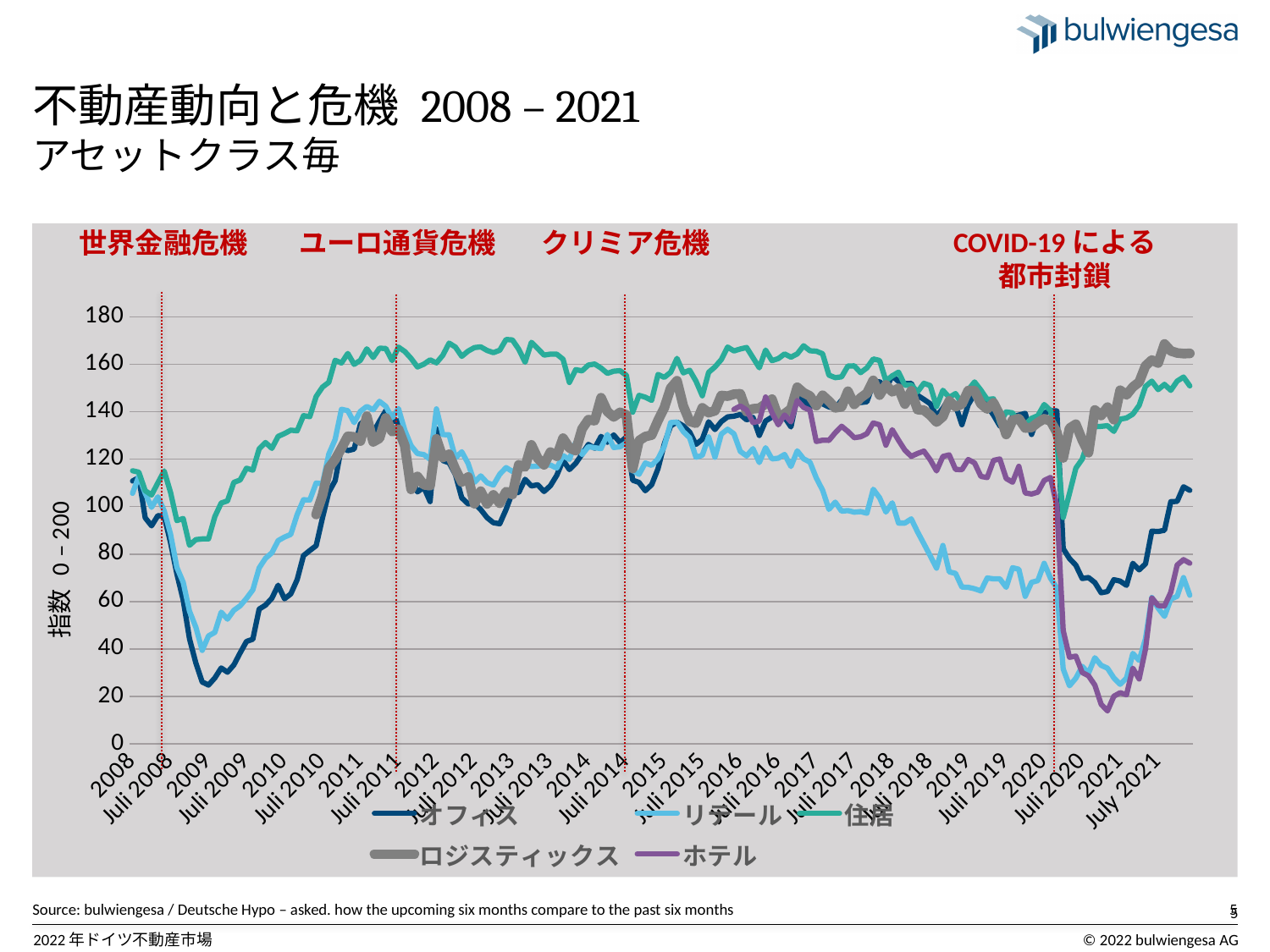
Which series has the lowest value at 2021? ホテル At July 2021, which series has the higher value, ロジスティックス or リテール? ロジスティックス Is the value for オフィス at 2009 greater or less than 40? less Which series are listed in the chart legend? オフィス, リテール, 住居, ロジスティックス, ホテル At 2019, which series has the higher value, 住居 or リテール? 住居 Is the value for ホテル at 2021 greater or less than 40? less Between 2017 and 2019, does the value for リテール rise or fall? fall How many crisis events are marked with labels above the chart? 4 Is the value for 住居 at Juli 2011 greater or less than 140? greater What kind of chart is shown on the slide? line chart How many series does the chart legend list? 5